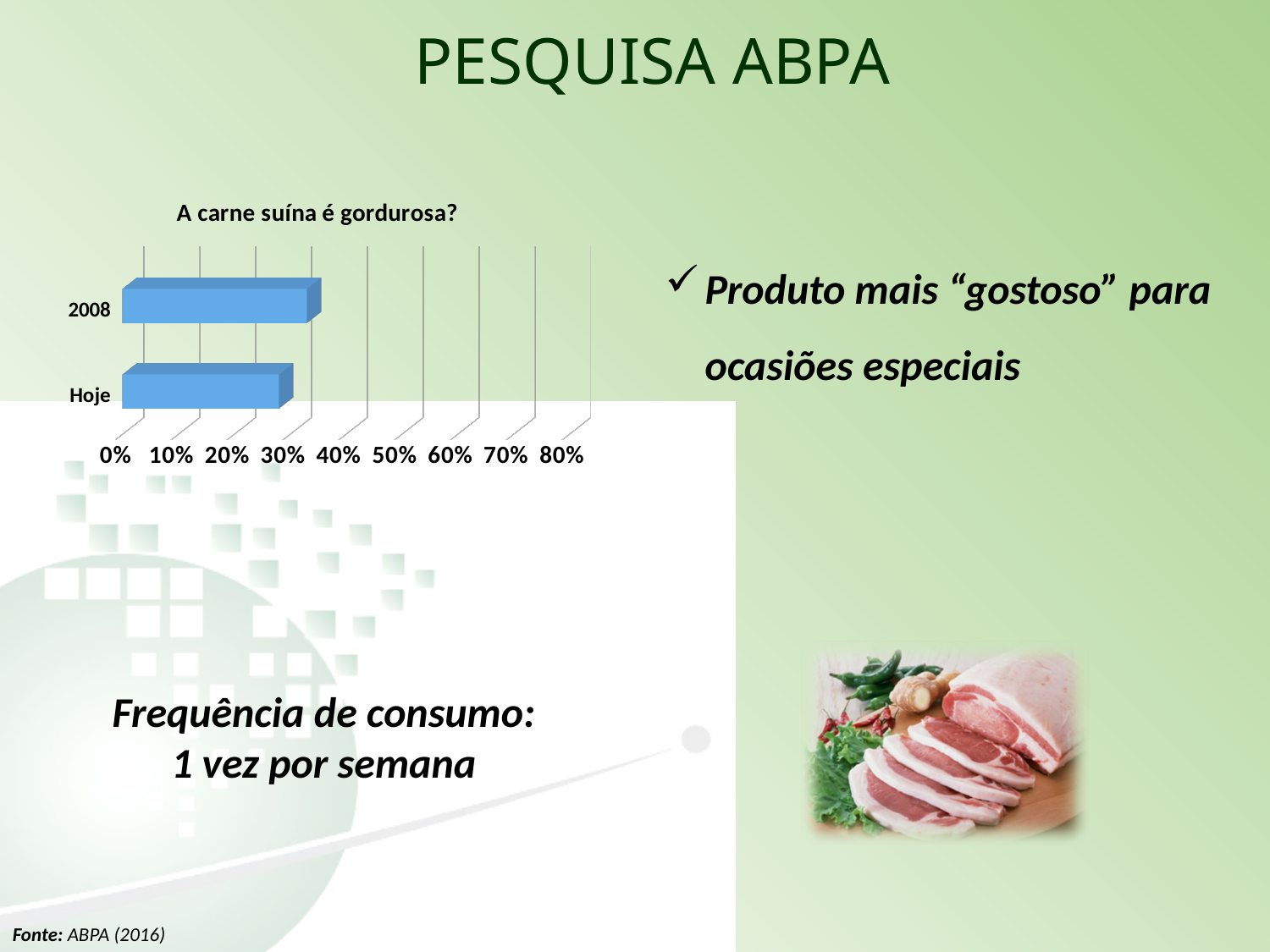
Is the value for 2008 greater or less than 20%? greater Do the values rise or fall from 2008 to Hoje? fall What kind of chart is shown on the slide? bar chart What is the title of the chart? A carne suína é gordurosa? Is the value for 2008 greater or less than 40%? less Which category has the highest value in the chart? 2008 What is the highest value shown on the chart's percentage axis? 80% How many categories does the chart show? 2 Which category has the lowest value in the chart? Hoje Which is larger, the value for 2008 or the value for Hoje? 2008 Is the value for Hoje greater or less than 40%? less